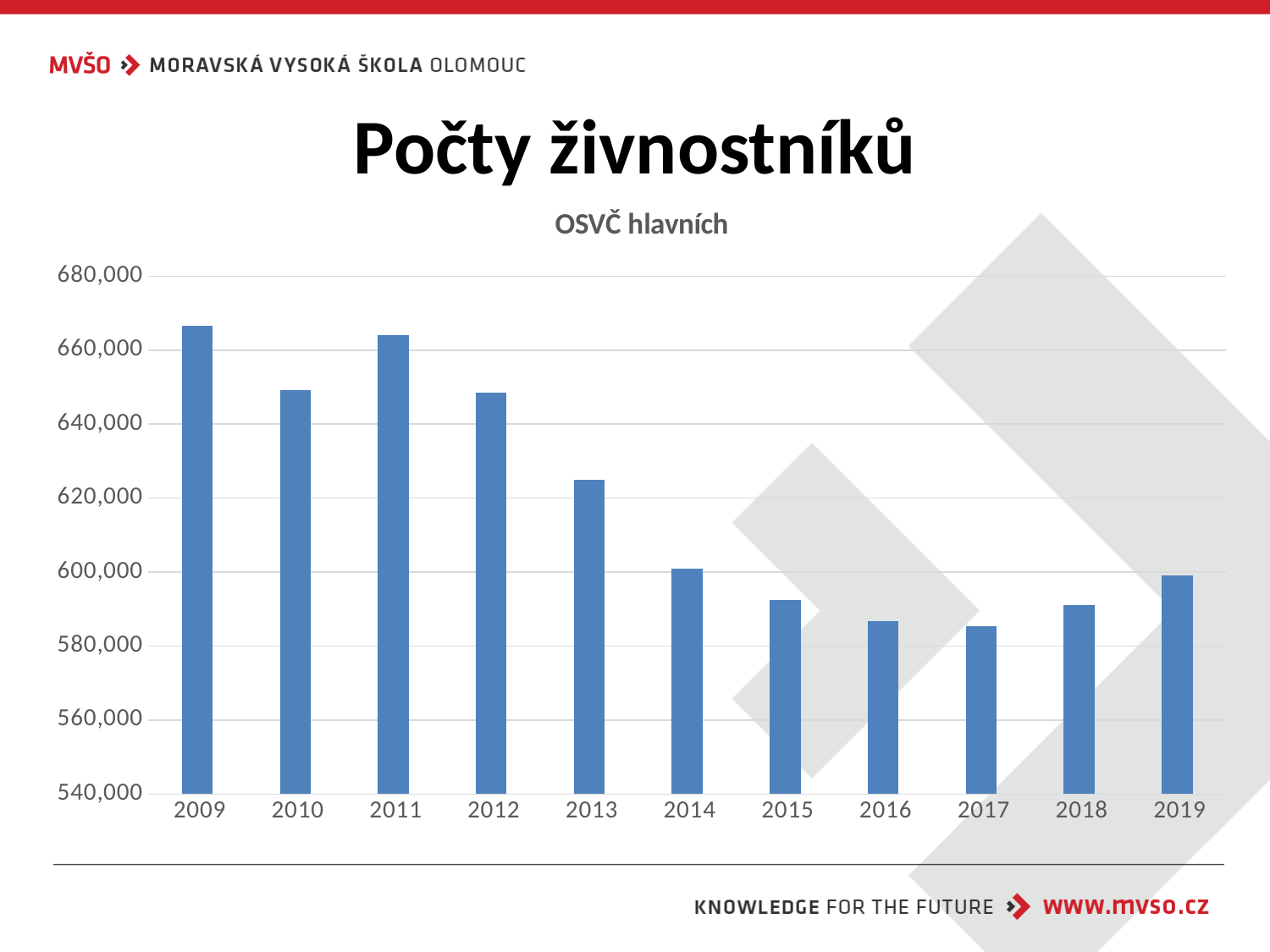
Do the values generally rise or fall from 2009 to 2017? fall What is the title of the chart? OSVČ hlavních Which year has the larger value, 2013 or 2018? 2013 How many years are shown on the x axis of the chart? 11 What kind of chart is shown on the slide? bar chart Which year has the larger value, 2016 or 2019? 2019 Is the value for 2010 greater or less than 640,000? greater Is the value for 2012 greater or less than 660,000? less Is the value for 2017 greater or less than 580,000? greater Which year has the larger value, 2009 or 2010? 2009